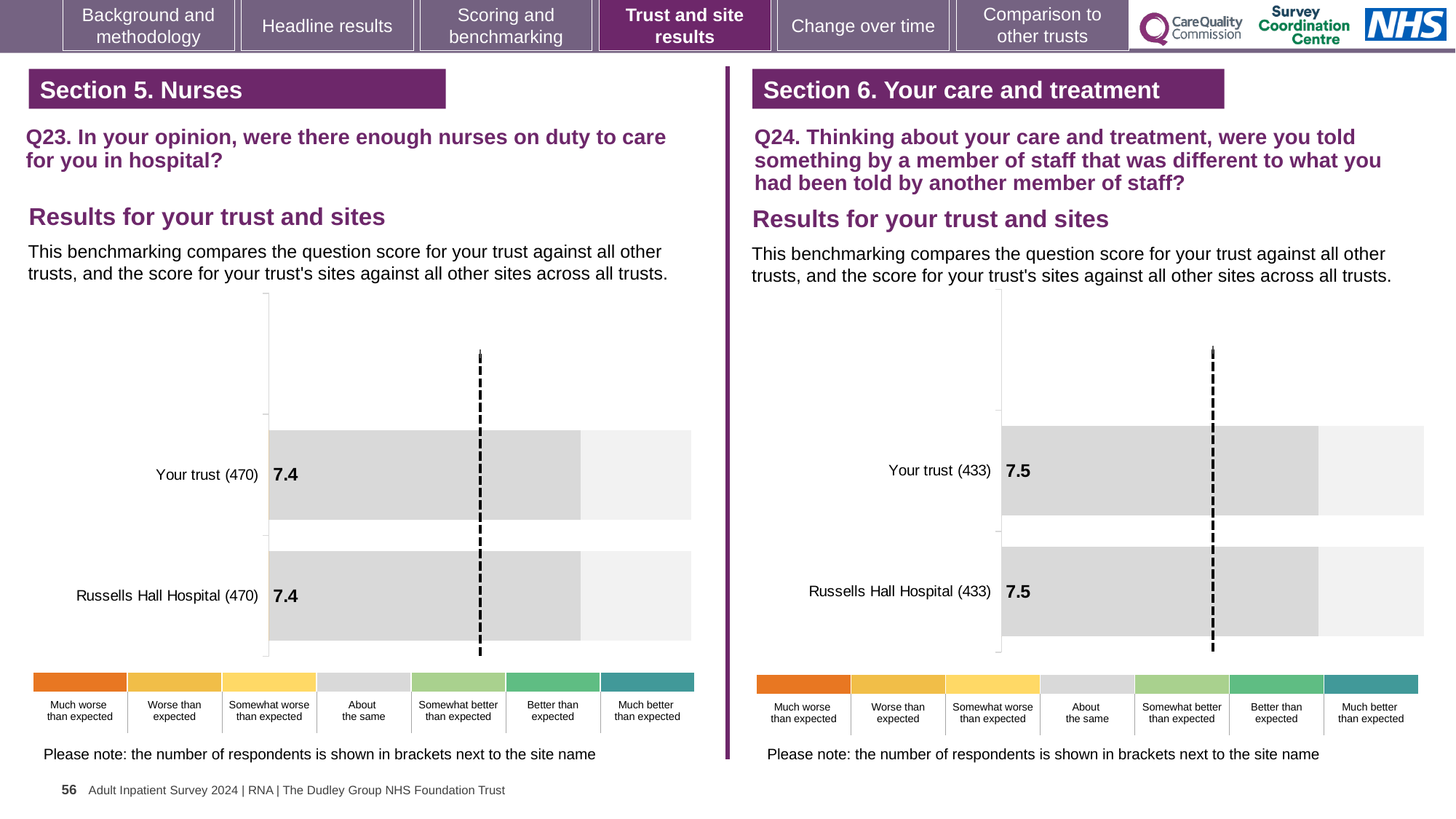
In the Q23 chart on the left, how many respondents are shown in brackets for Your trust? 470 In the Q24 chart on the right, what is the difference between the score for Your trust and the score for Russells Hall Hospital? 0 What kind of chart is the Q23 chart on the left? Bar chart In the Q24 chart on the right, what is the score for Your trust? 7.5 In the Q23 chart on the left, what is the score for Russells Hall Hospital? 7.4 In the Q23 chart on the left, what is the difference between the score for Your trust and the score for Russells Hall Hospital? 0 In the Q24 chart on the right, what is the score for Russells Hall Hospital? 7.5 In the Q23 chart on the left, what is the score for Your trust? 7.4 How many bars are plotted in the Q24 chart on the right? 2 In the Q24 chart on the right, how many respondents are shown in brackets for Russells Hall Hospital? 433 How many bars are plotted in the Q23 chart on the left? 2